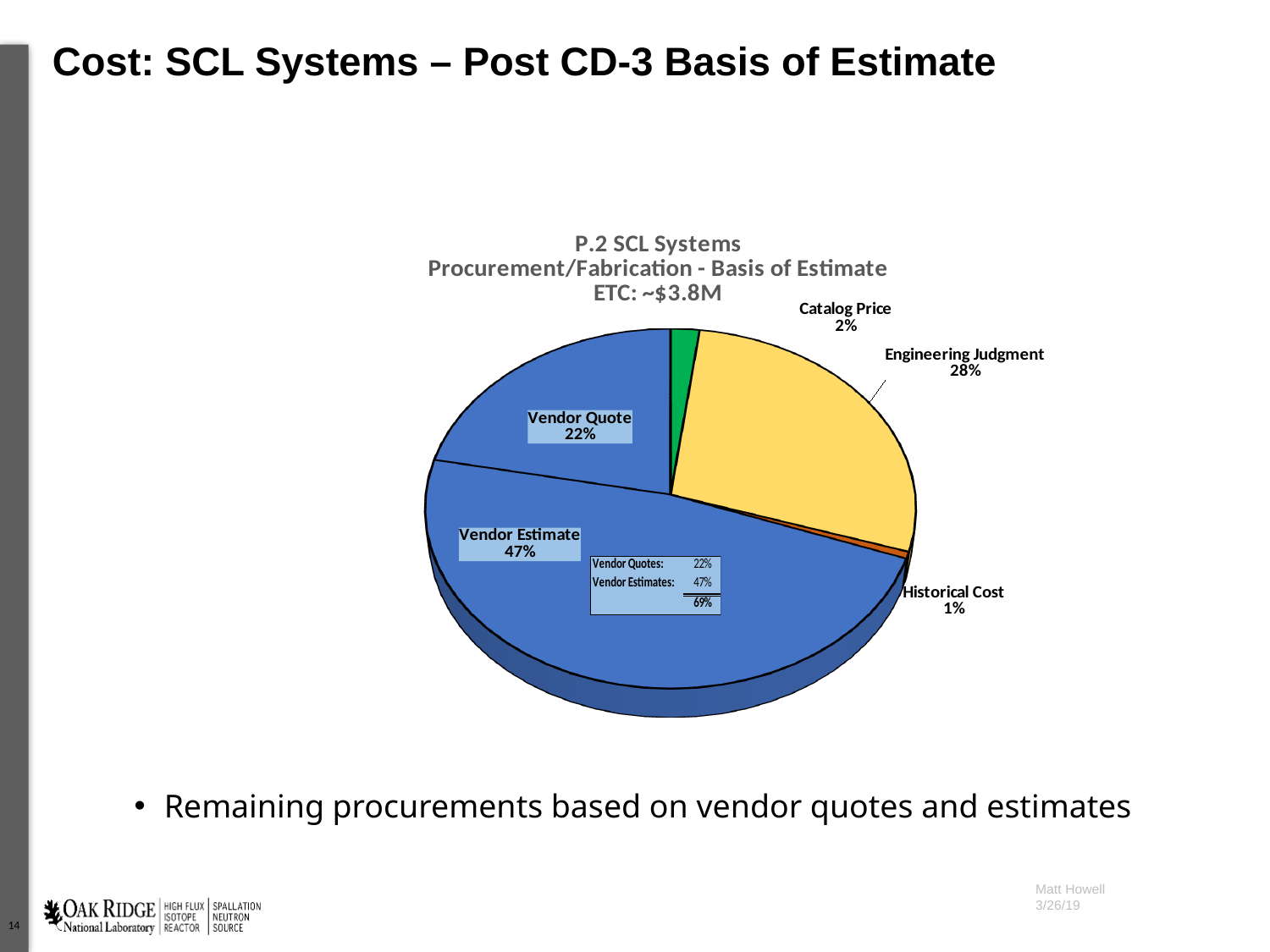
What share of the pie does Engineering Judgment represent? 28% What is the value shown for Catalog Price? 2% How many categories are shown in the pie chart? 5 What share of the pie does Vendor Estimate represent? 47% Which category has the largest slice of the pie? Vendor Estimate What ETC value is stated in the chart title? ~$3.8M What is the difference between the Vendor Estimate and Vendor Quote shares? 25% What is the value shown for Historical Cost? 1% Which category has the smallest slice of the pie? Historical Cost What is the value shown for Vendor Quote? 22% What kind of chart is shown on the slide? pie chart Which is larger, the Engineering Judgment share or the Vendor Quote share? Engineering Judgment